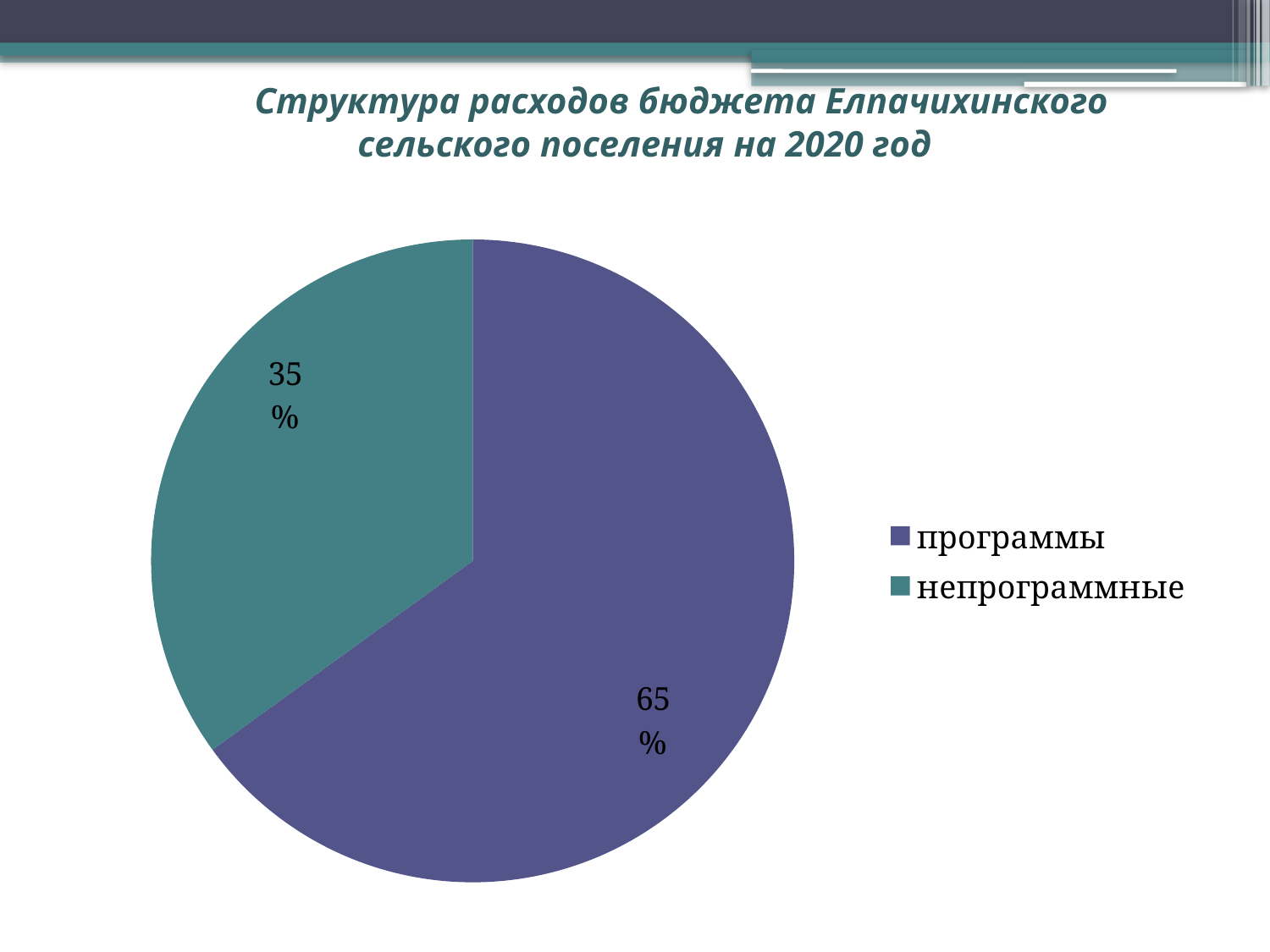
What colour is the "непрограммные" slice? teal What kind of chart is shown on the slide? pie chart How many entries does the legend list? 2 Which is larger, the "программы" slice or the "непрограммные" slice? программы What is the difference in percentage points between the "программы" and "непрограммные" slices? 30 What is the title of the slide? Структура расходов бюджета Елпачихинского сельского поселения на 2020 год What share of the pie does the "непрограммные" slice represent? 35% Which category has the largest slice of the pie? программы What share of the pie does the "программы" slice represent? 65% How many slices does the pie chart have? 2 Which category has the smallest slice of the pie? непрограммные